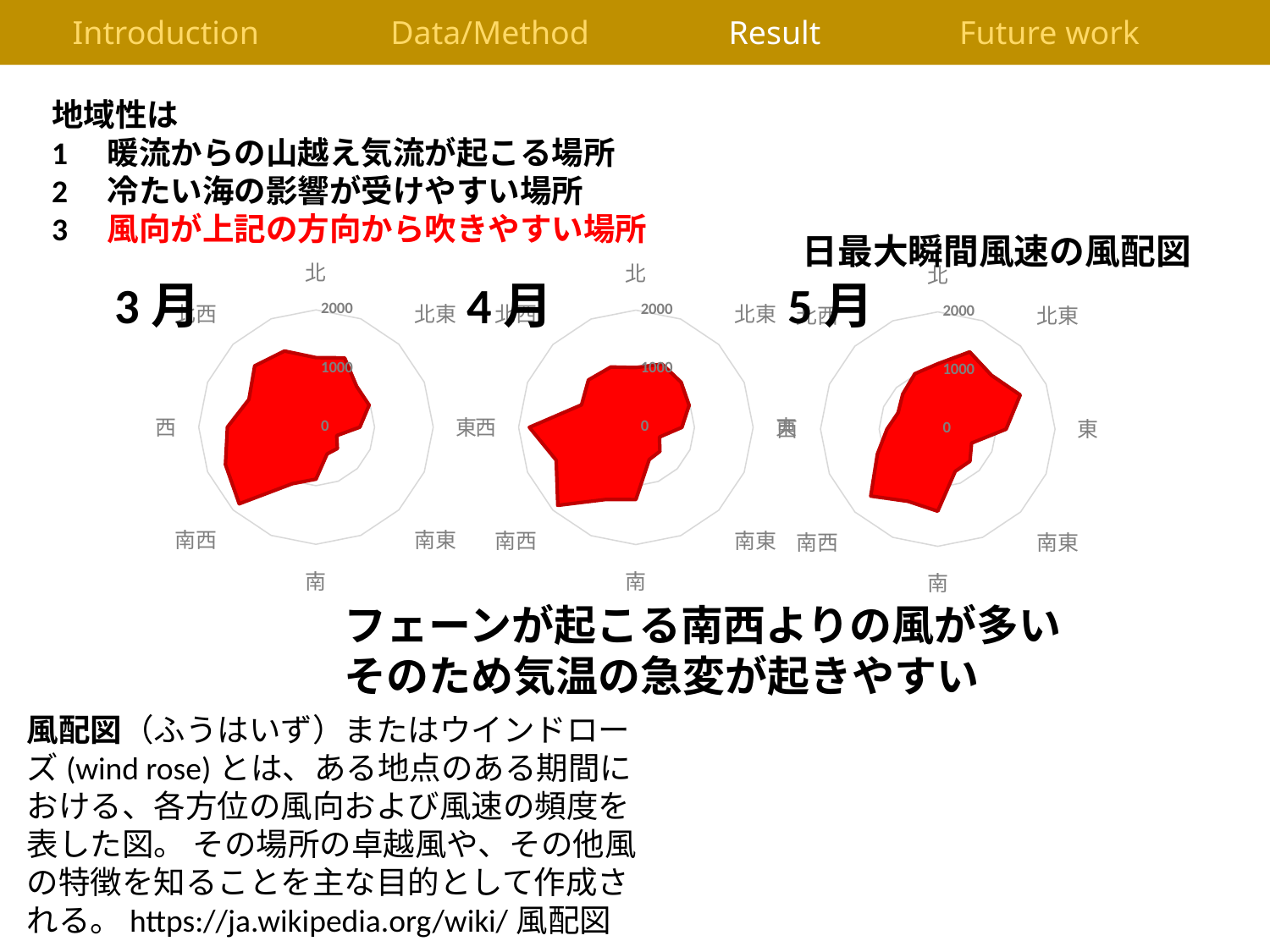
In the 3月 chart, is the value for 北東 greater or less than 2000? less What is the maximum value shown on the radial axis of the 4月 chart? 2000 How many wind rose charts are shown on the slide? 3 What is the title given above the wind rose charts? 日最大瞬間風速の風配図 In the 5月 chart, which direction has the highest value? 南西 In the 3月 chart, which direction has the highest value? 南西 In the 5月 chart, is the value for 南東 greater or less than 1000? less What kind of chart is the 3月 chart? Radar chart In the 4月 chart, is the value for 西 greater or less than 1000? greater In the 5月 chart, which is larger, the value for 南西 or the value for 東? 南西 How many direction categories does the 4月 chart have? 8